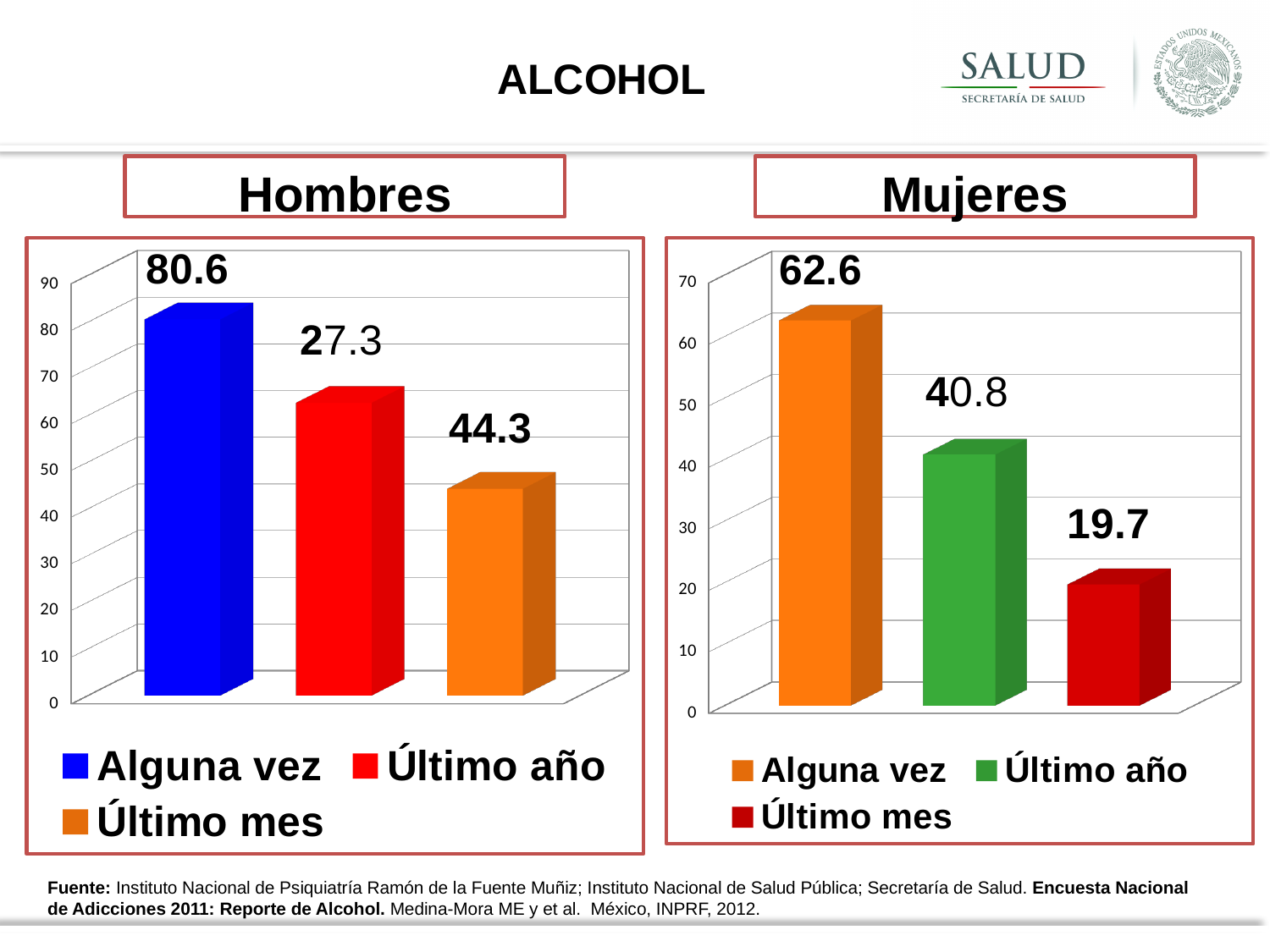
In the Mujeres chart, what is the value for Último año? 40.8 In the Mujeres chart, which category has the highest value? Alguna vez In the Mujeres chart, which category has the lowest value? Último mes Which is larger: the Alguna vez value in the Hombres chart or the Alguna vez value in the Mujeres chart? Hombres In the Hombres chart, what is the value for Último mes? 44.3 In the Mujeres chart, what is the difference between Alguna vez and Último mes? 42.9 In the Mujeres chart, what is the value for Alguna vez? 62.6 How many entries does the legend of the Hombres chart list? 3 In the Mujeres chart, what is the value for Último mes? 19.7 In the Hombres chart, what is the value for Alguna vez? 80.6 What kind of chart is the Mujeres chart? Bar chart In the Hombres chart, what is the difference between Alguna vez and Último mes? 36.3